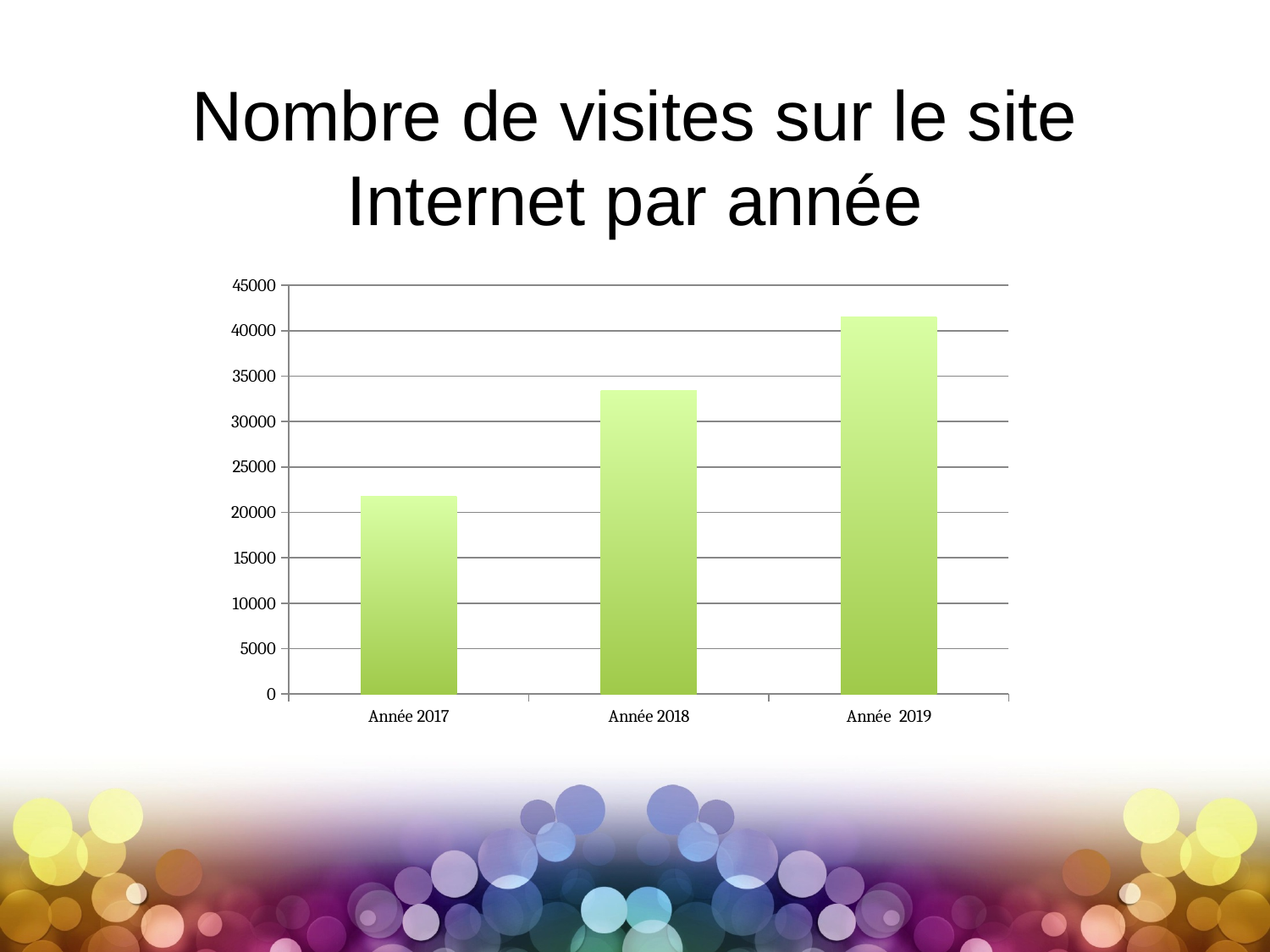
Do the values rise or fall from Année 2017 to Année 2019? rise Is the value for Année 2018 greater or less than 30000? greater Which year has the lowest number of visits? Année 2017 Which is larger, the value for Année 2018 or the value for Année 2019? Année 2019 What is the title of the slide containing the chart? Nombre de visites sur le site Internet par année What kind of chart is shown on the slide? bar chart Is the value for Année 2019 greater or less than 40000? greater Which year has the highest number of visits? Année 2019 How many categories (years) are shown on the x axis? 3 What is the maximum value shown on the y axis? 45000 Is the value for Année 2017 greater or less than 25000? less